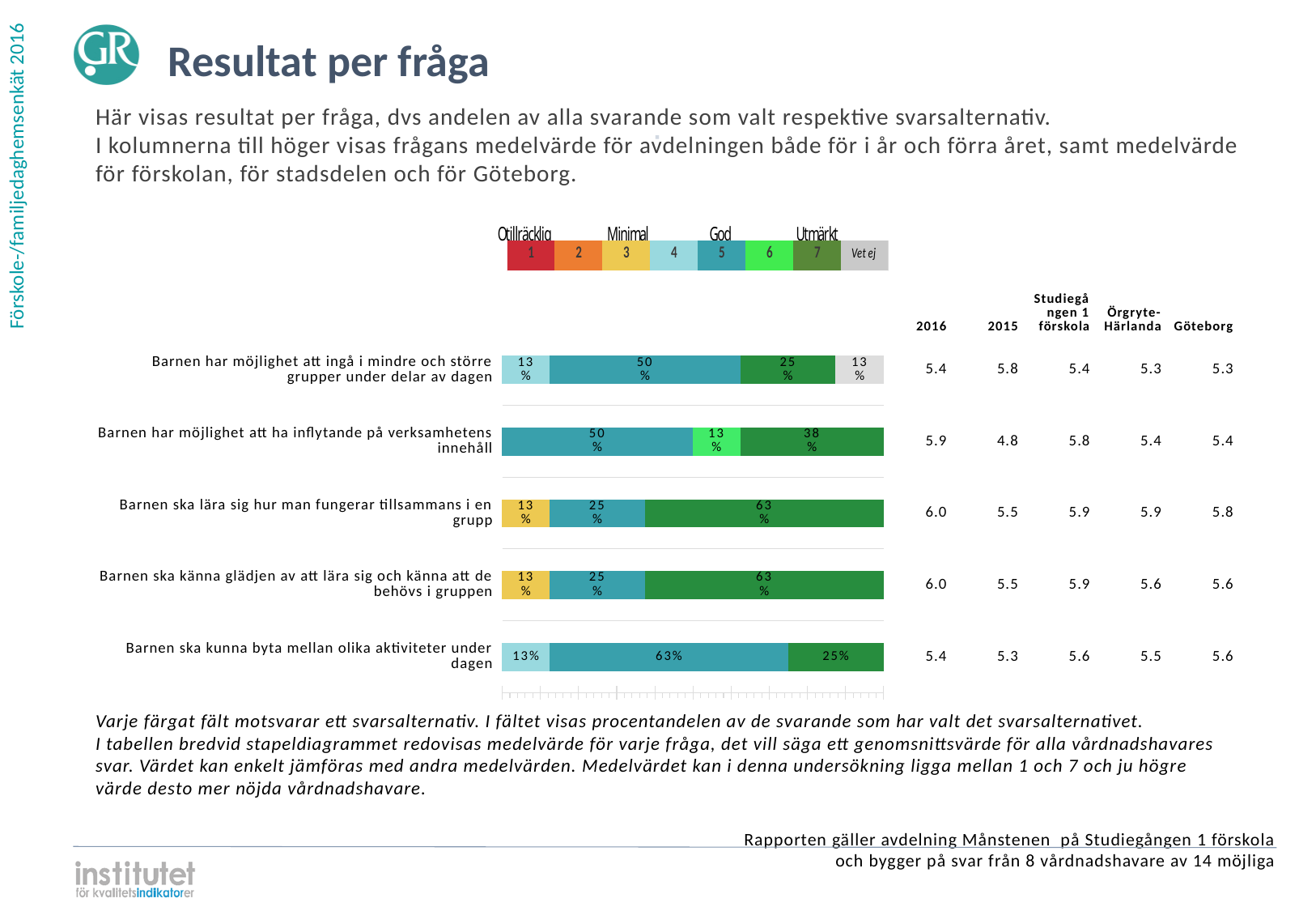
What is the largest segment in the bar for 'Barnen ska lära sig hur man fungerar tillsammans i en grupp'? 63% What is the value of the dark green segment in the bar for 'Barnen har möjlighet att ha inflytande på verksamhetens innehåll'? 38% How many answer alternatives does the legend above the chart list? 8 What is the difference between the 50% segment and the 13% segment in the bar for 'Barnen har möjlighet att ha inflytande på verksamhetens innehåll'? 37 percentage points Which is larger in the bar for 'Barnen ska kunna byta mellan olika aktiviteter under dagen': the teal segment or the dark green segment? The teal segment (63%) What kind of chart is used to show the results per question? Stacked bar chart What is the 2015 mean value shown for 'Barnen har möjlighet att ha inflytande på verksamhetens innehåll'? 4.8 What label does the legend give to the scale values 1 and 2? Otillräcklig What is the largest segment in the bar for 'Barnen ska kunna byta mellan olika aktiviteter under dagen'? 63% What percentage is shown for the grey 'Vet ej' segment in the bar for 'Barnen har möjlighet att ingå i mindre och större grupper under delar av dagen'? 13% How many questions (categories) are shown in the bar chart? 5 What is the 2016 mean value shown for 'Barnen ska lära sig hur man fungerar tillsammans i en grupp'? 6.0